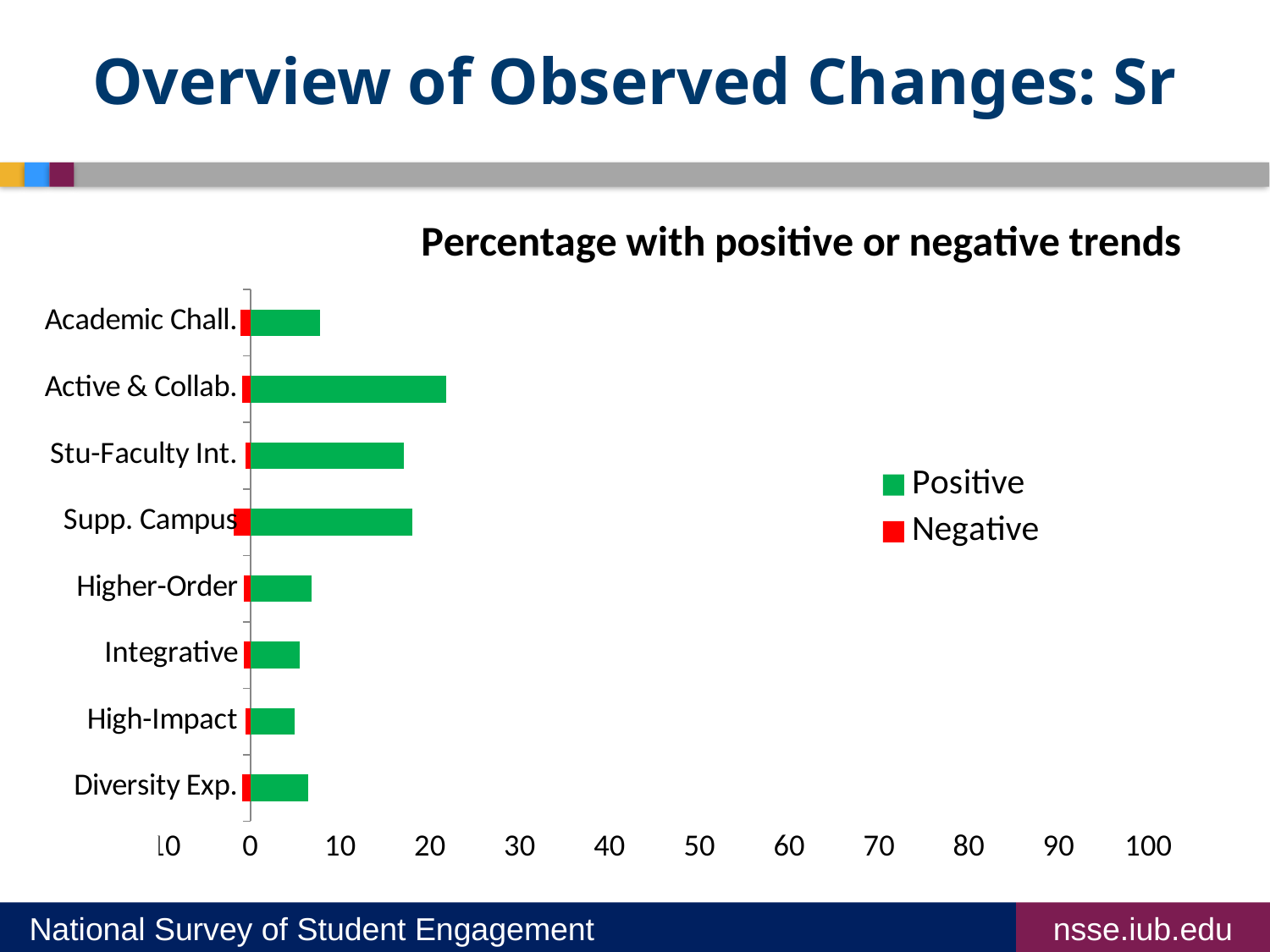
Which has the larger Positive value, Active & Collab. or Academic Chall.? Active & Collab. Is the Positive value for Supp. Campus greater or less than 10? greater Is the Positive value for Academic Chall. greater or less than 10? less What is the title of the chart? Percentage with positive or negative trends Is the Positive value for Active & Collab. greater or less than 20? greater What kind of chart is shown on the slide? bar chart How many series does the legend list? 2 Which has the larger Positive value, Active & Collab. or Stu-Faculty Int.? Active & Collab. How many categories are plotted on the chart? 8 Which category has the highest Positive value? Active & Collab. Which colour represents the Negative series in the legend? red